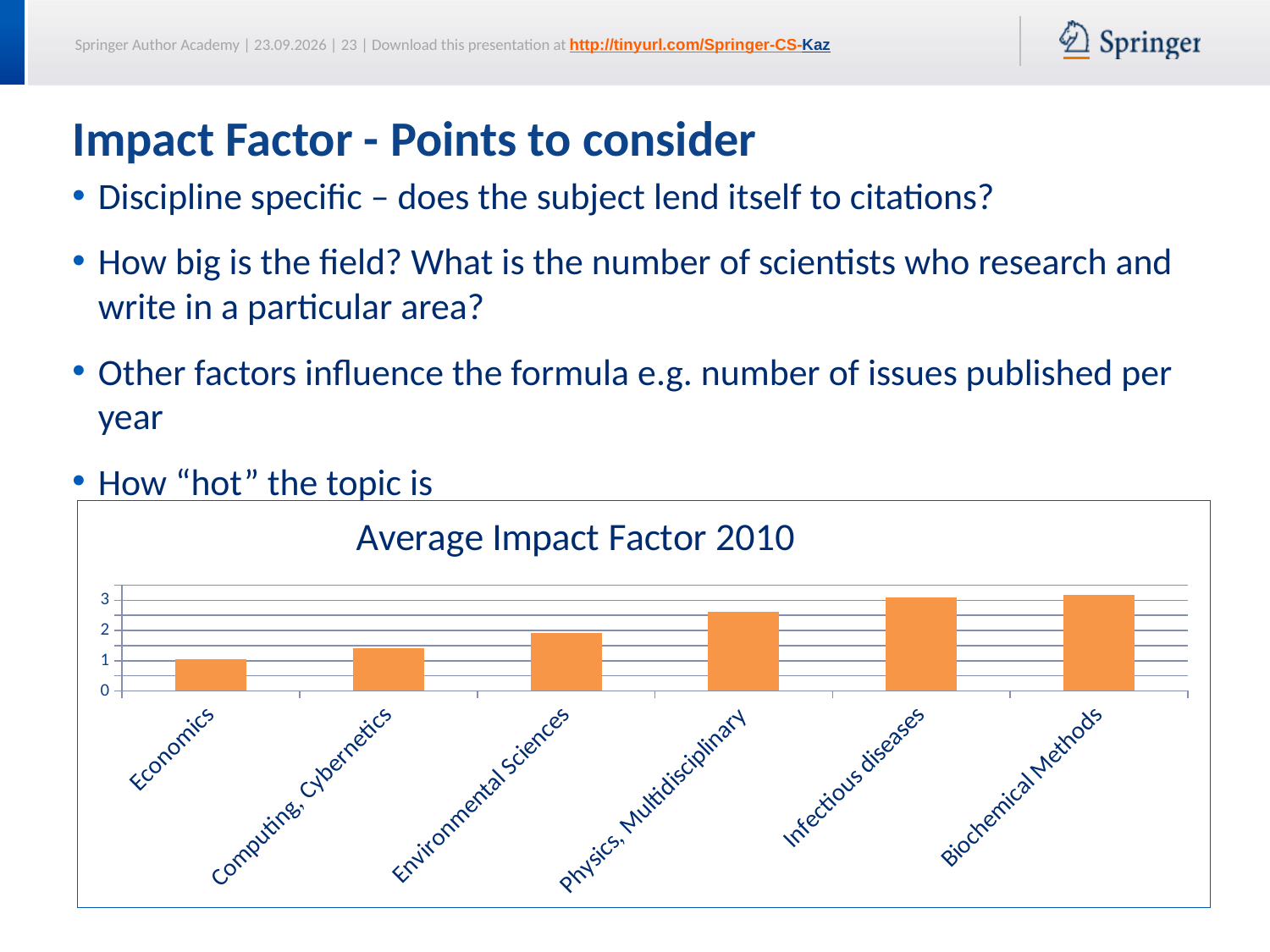
Which is larger, the value for Economics or the value for Environmental Sciences? Environmental Sciences Which is larger, the value for Physics, Multidisciplinary or the value for Computing, Cybernetics? Physics, Multidisciplinary What kind of chart is shown on the slide? bar chart Which category has the lowest average impact factor? Economics Is the value for Physics, Multidisciplinary greater or less than 2? greater Do the values rise or fall moving from left to right along the x axis? rise Is the value for Computing, Cybernetics greater or less than 2? less Is the value for Biochemical Methods greater or less than 3? greater What is the title of the chart? Average Impact Factor 2010 How many categories are shown on the x axis of the chart? 6